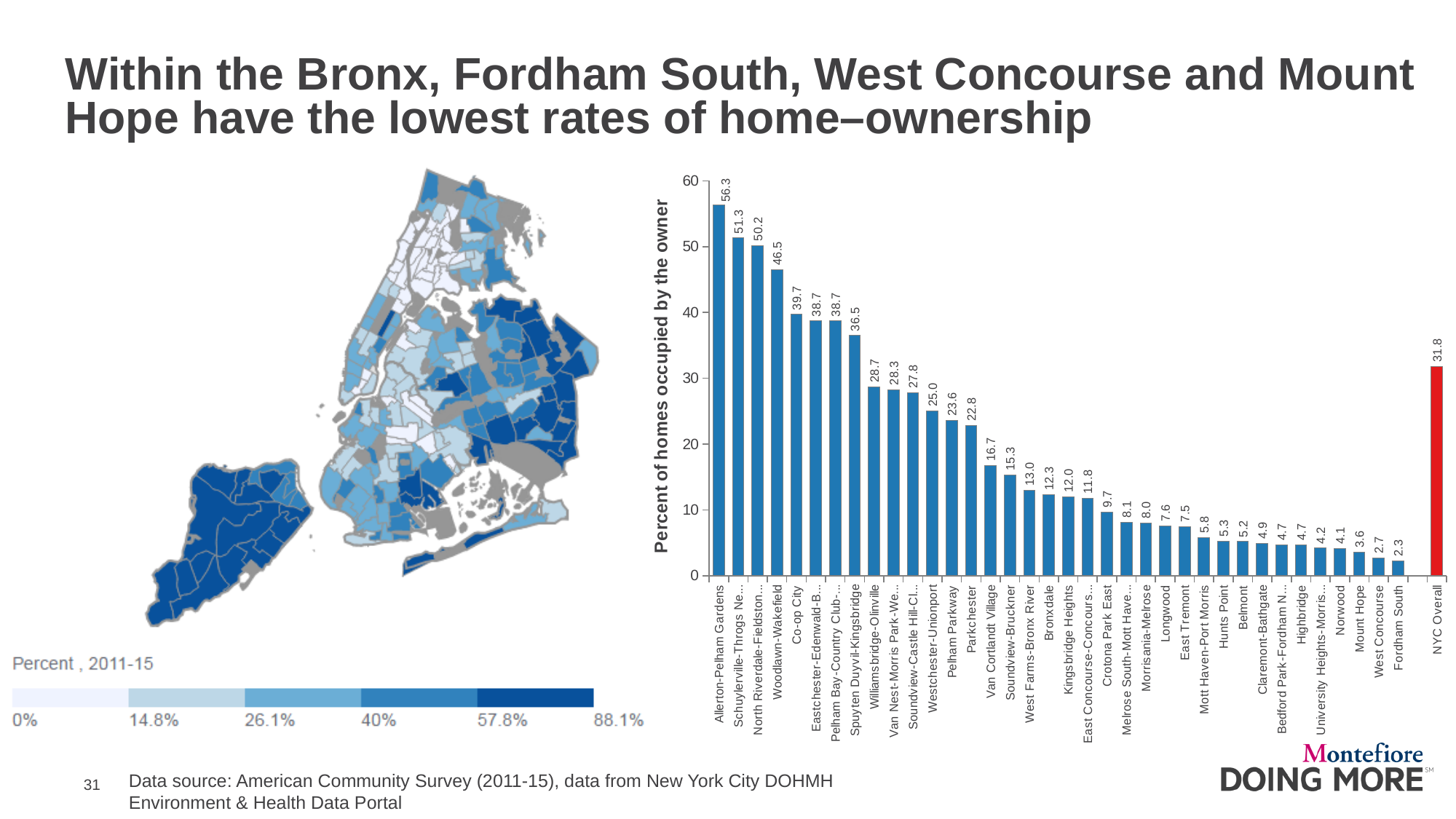
In the bar chart, how many bars are plotted, including NYC Overall? 37 In the bar chart, do the neighborhood values rise or fall from left to right (excluding NYC Overall)? Fall In the bar chart, is the value for Woodlawn-Wakefield greater or less than 40? greater In the bar chart, what is the value for Fordham South? 2.3 In the bar chart, what is the percent of homes occupied by the owner in Co-op City? 39.7 What kind of chart is shown on the right side of the slide? Bar chart In the bar chart, which bar is colored red instead of blue? NYC Overall In the bar chart, what is the value shown for NYC Overall? 31.8 In the bar chart, which Bronx neighborhood has the highest percent of homes occupied by the owner? Allerton-Pelham Gardens In the bar chart, which neighborhood has the lowest percent of homes occupied by the owner? Fordham South In the bar chart, what is the difference between the values for Allerton-Pelham Gardens and Fordham South? 54.0 In the bar chart, which has a higher value, Parkchester or Van Cortlandt Village? Parkchester